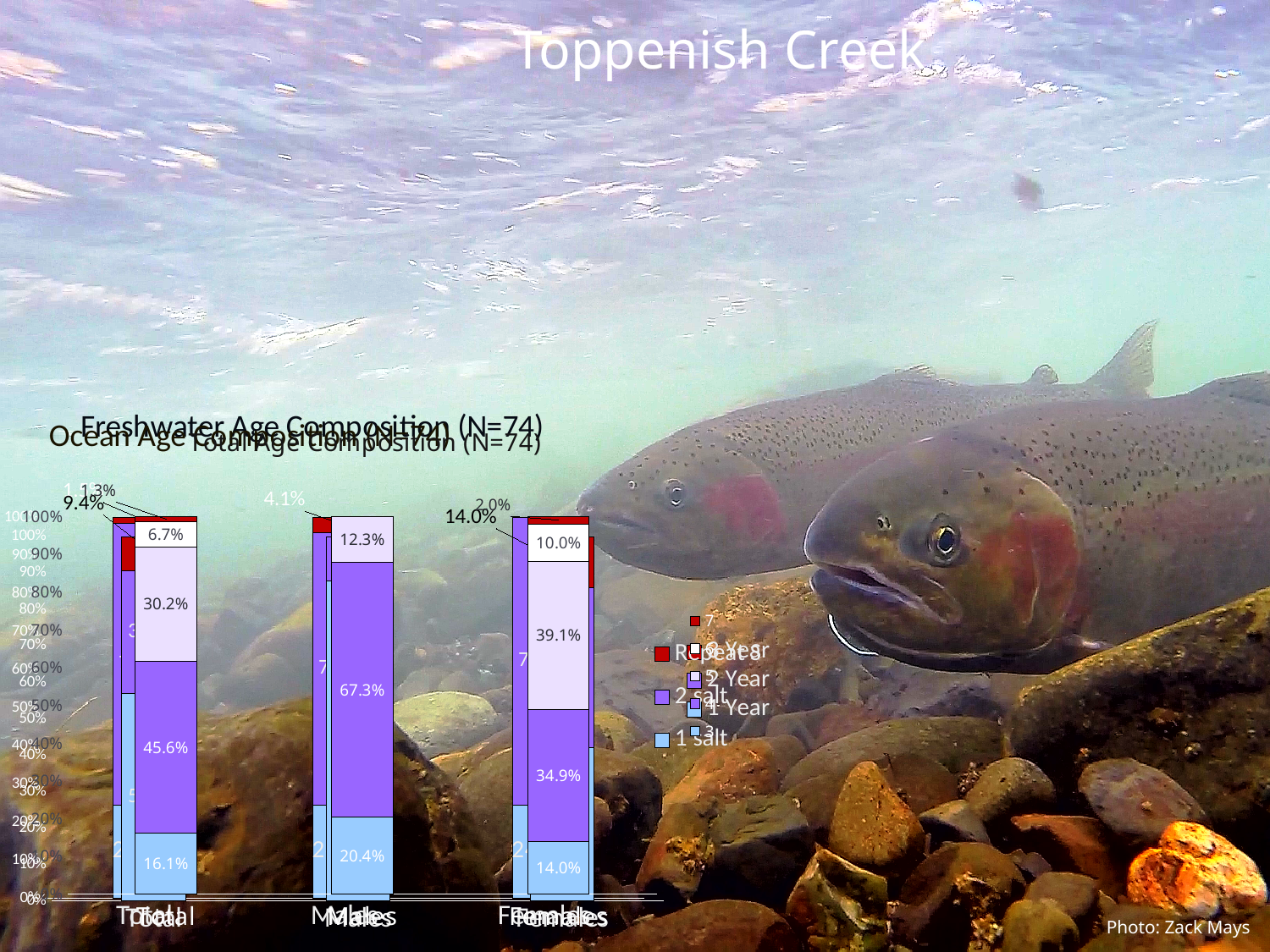
In the front chart with percentage data labels, which category has the largest bottom (light blue) segment? Males What type of chart is used on this slide? Stacked bar chart In the front chart with percentage data labels, which category has the smallest bottom (light blue) segment? Females In the front chart with percentage data labels, what is the value of the bottom (light blue) segment of the Females bar? 14.0% What sample size (N) is stated in the chart titles? 74 How many categories are shown along the x axis of the stacked bar charts? 3 In the front chart with percentage data labels, what is the value of the purple segment of the Males bar? 67.3% In the front chart with percentage data labels, what is the difference between the purple segment of the Total bar (45.6%) and the purple segment of the Females bar (34.9%)? 10.7 percentage points In the front chart with percentage data labels, what is the value of the bottom (light blue) segment of the Total bar? 16.1% In the front chart with percentage data labels, what is the value of the lavender segment of the Females bar? 39.1% In the front chart with percentage data labels, what is the value of the white top segment of the Total bar? 6.7% In the front chart with percentage data labels, is the purple segment larger for Males or for Total? Males